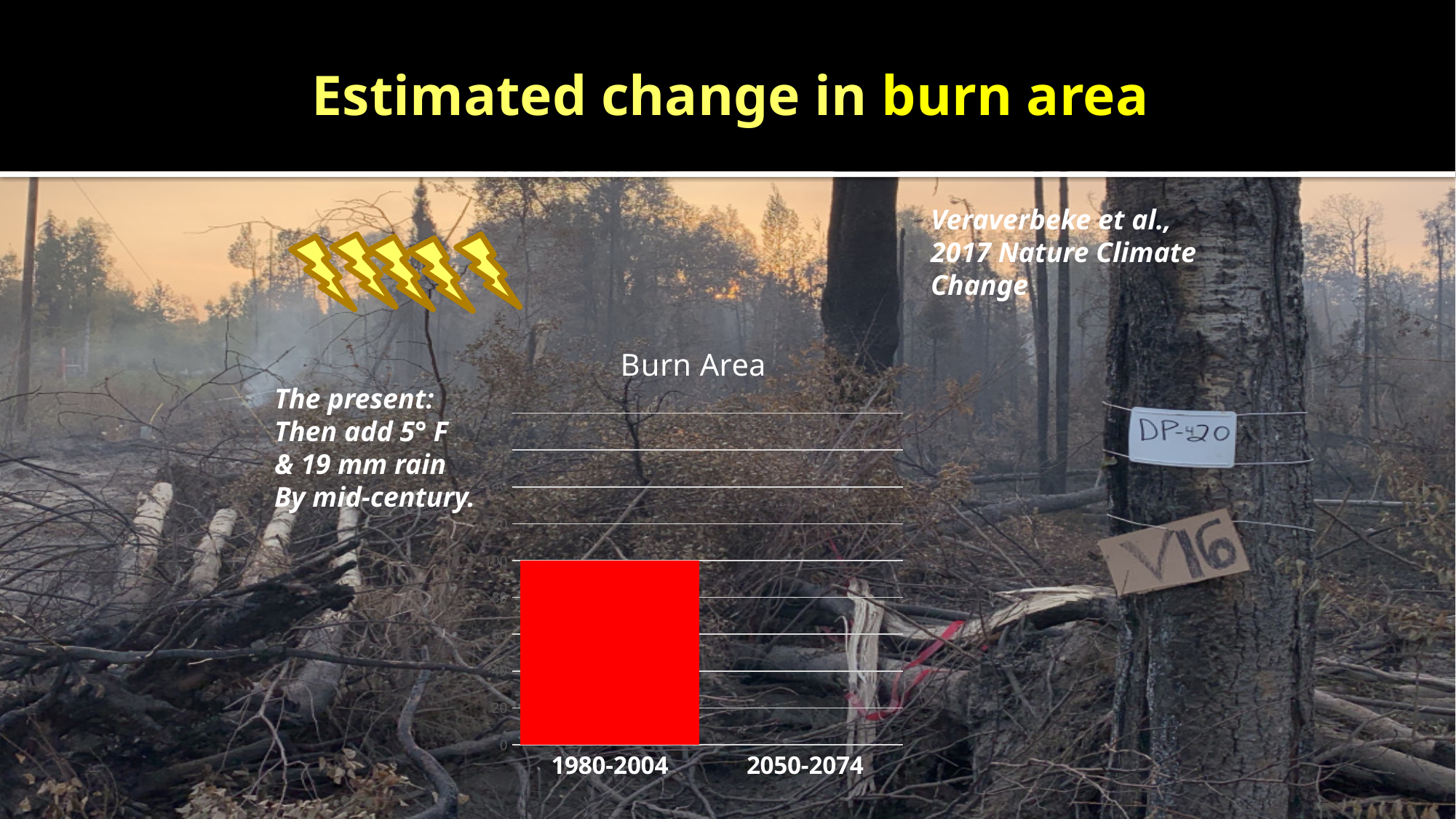
What kind of chart is shown on the slide? bar chart How many categories are labelled on the x axis of the chart? 2 What is the first category label on the x axis? 1980-2004 What is the value of the bar for 1980-2004? 100 Is the value for 1980-2004 greater or less than 120? less What is the title of the chart? Burn Area What is the second category label on the x axis? 2050-2074 What colour is the bar for 1980-2004? red Is the value for 1980-2004 greater or less than 80? greater